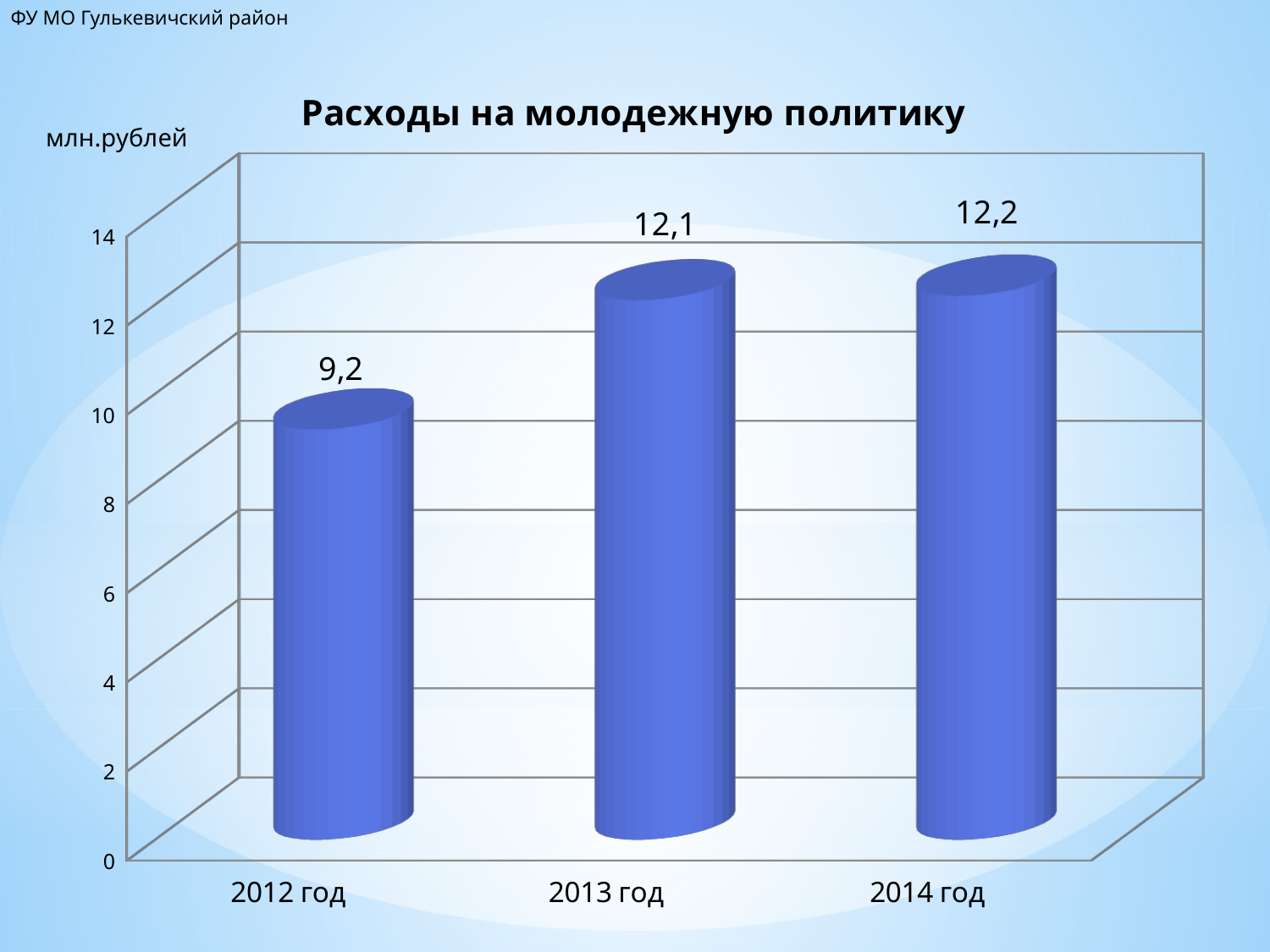
What is the value for 2013 год? 12,1 Which year has the lowest value? 2012 год What is the value for 2012 год? 9,2 Is the value for 2012 год greater or less than 10? less How many years are shown on the chart? 3 Is the value for 2014 год greater or less than 12? greater Which is larger, the value for 2012 год or the value for 2013 год? 2013 год What is the difference between the values for 2014 год and 2012 год? 3 Do the values rise or fall from 2012 год to 2014 год? rise What kind of chart is this? bar chart What is the difference between the values for 2013 год and 2012 год? 2,9 What is the value for 2014 год? 12,2